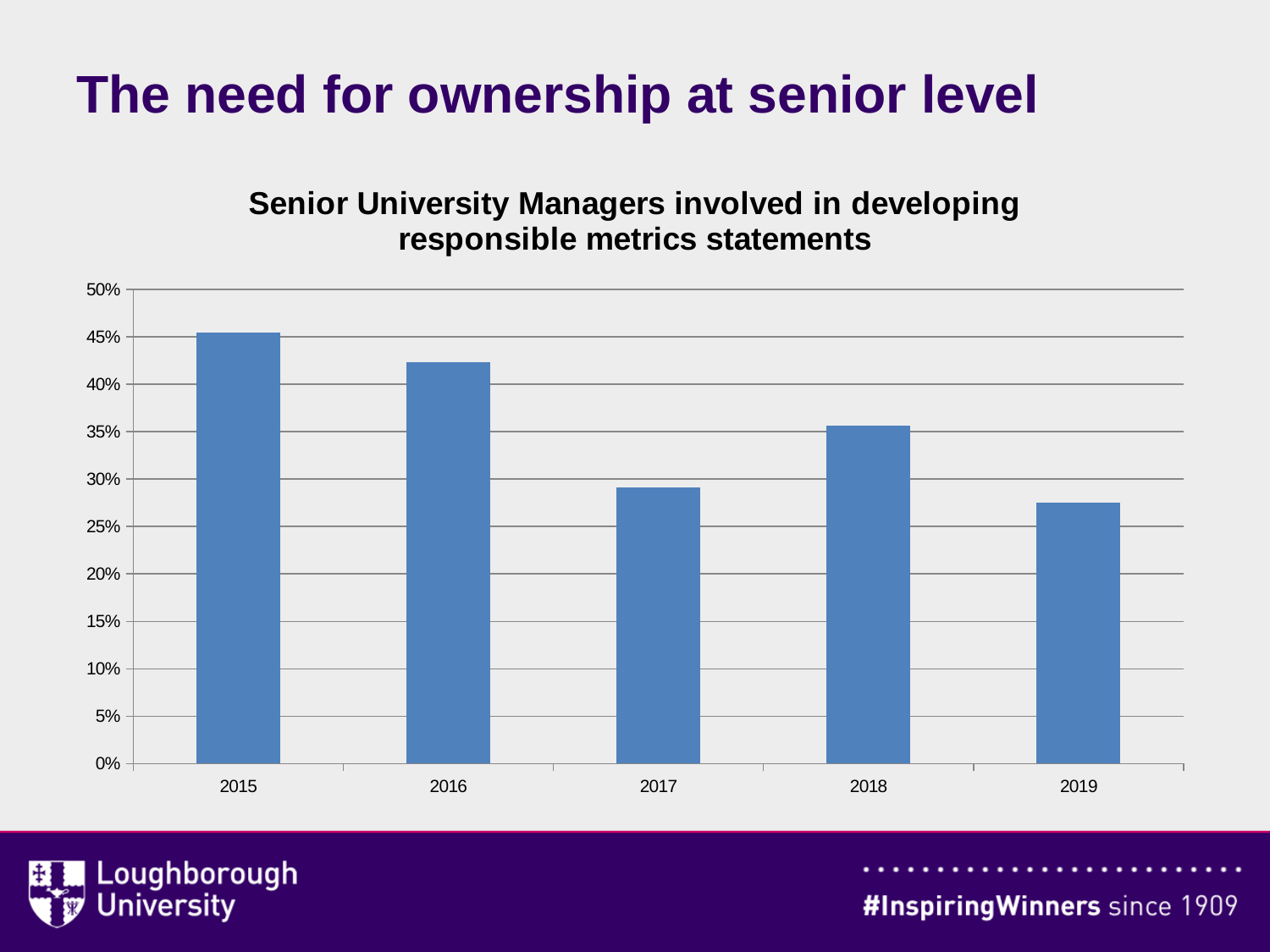
Which is larger, the value for 2017 or the value for 2018? 2018 How many years are shown on the x axis of the chart? 5 Which is larger, the value for 2016 or the value for 2018? 2016 Which year has the highest value in the chart? 2015 Is the value for 2017 greater or less than 30%? less Is the value for 2016 greater or less than 40%? greater Is the value for 2018 greater or less than 30%? greater Which year has the lowest value in the chart? 2019 What is the title of the chart? Senior University Managers involved in developing responsible metrics statements What kind of chart is shown on the slide? Bar chart